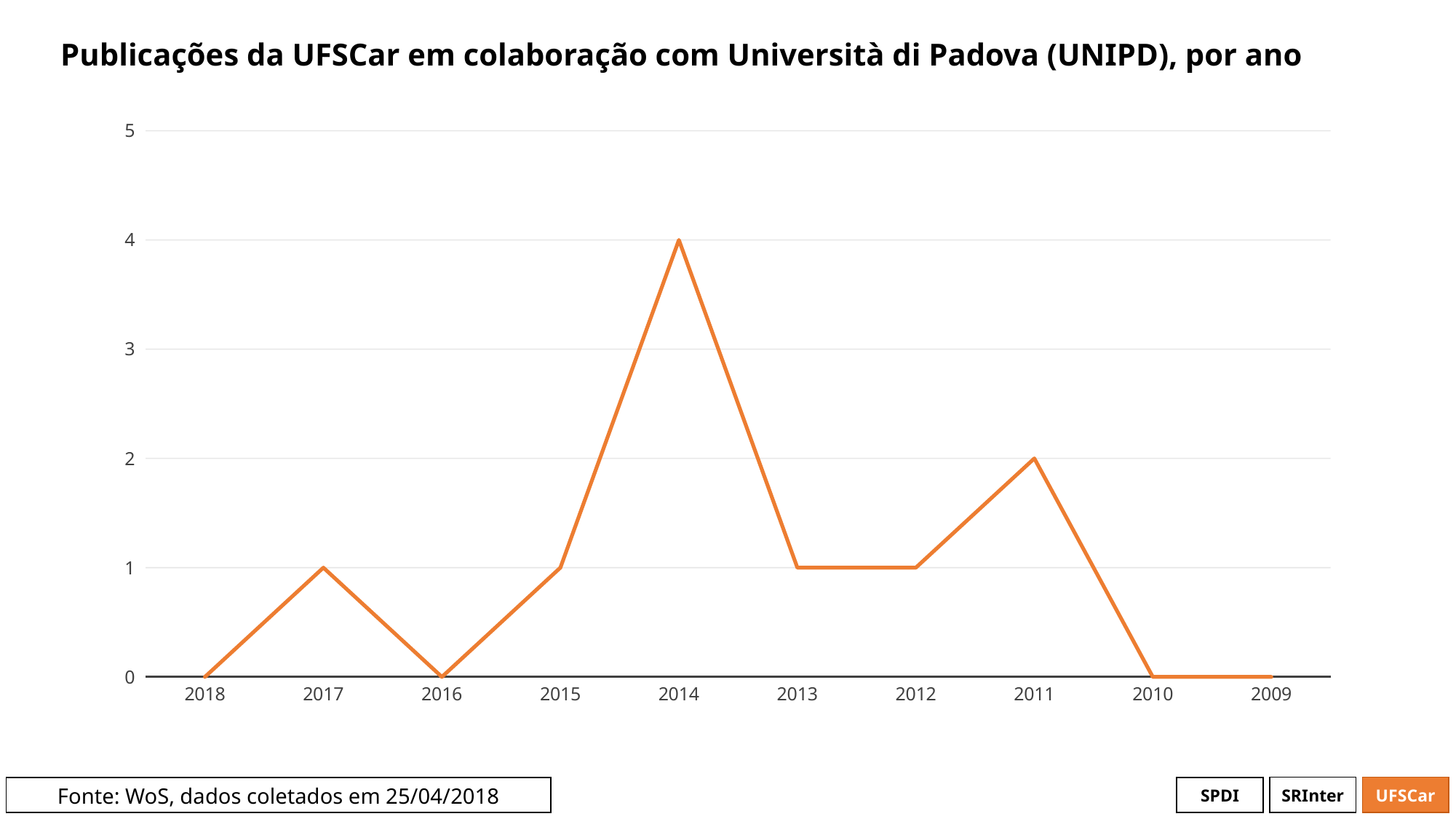
How many years are shown on the x axis? 10 What kind of chart is shown on the slide? line chart What is the title of the chart? Publicações da UFSCar em colaboração com Università di Padova (UNIPD), por ano Is the value for 2014 greater or less than 3? greater What is the number of publications for 2014? 4 Which year has the highest number of publications? 2014 What is the difference between the values for 2014 and 2011? 2 Which year has the larger value, 2013 or 2011? 2011 What is the number of publications for 2017? 1 What is the number of publications for 2010? 0 What is the number of publications for 2011? 2 What is the data source stated on the slide? WoS, dados coletados em 25/04/2018